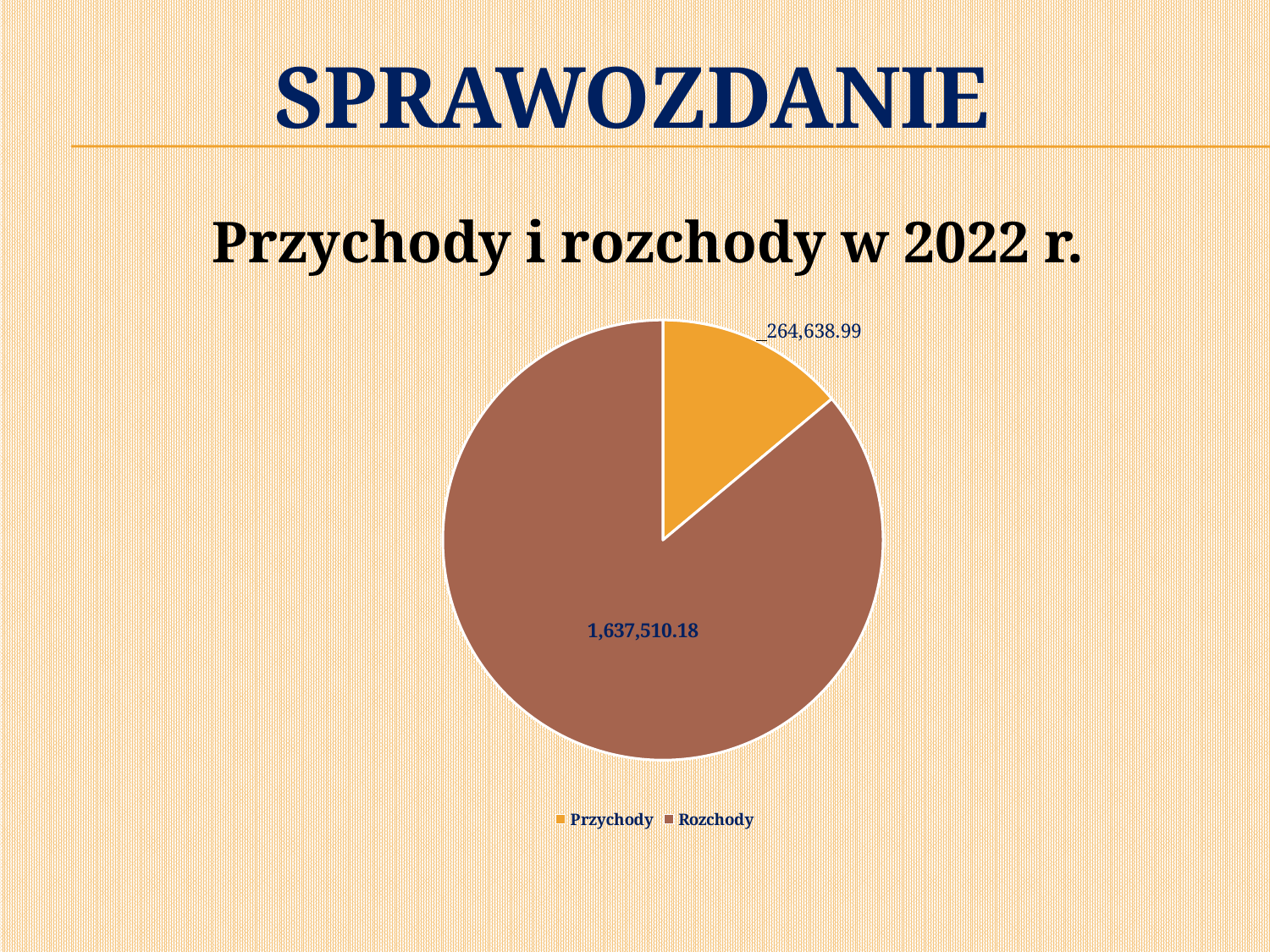
What is the title of the chart? Przychody i rozchody w 2022 r. What colour is the Przychody slice in the pie chart? orange Which category has the largest slice in the pie chart? Rozchody What is the value for Przychody in the pie chart? 264,638.99 How many slices does the pie chart have? 2 Which category has the smallest slice in the pie chart? Przychody Which is larger, Przychody or Rozchody? Rozchody What type of chart is shown on the slide? pie chart What is the total of the two values shown in the pie chart? 1,902,149.17 How many entries does the legend list? 2 What is the value for Rozchody in the pie chart? 1,637,510.18 What is the difference between Rozchody and Przychody? 1,372,871.19